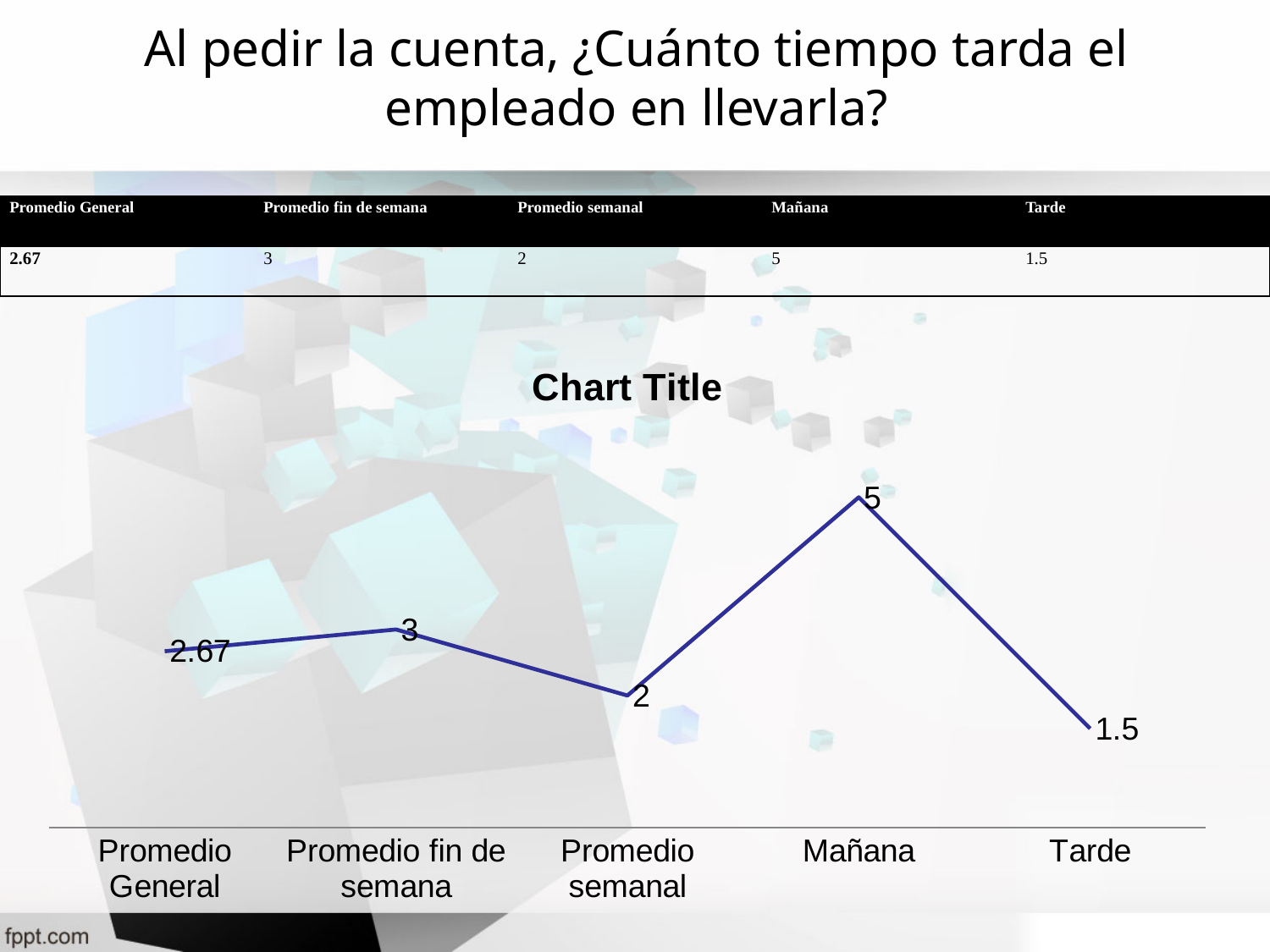
What is the difference between the values for Promedio fin de semana and Promedio semanal? 1 What is the value for Promedio General? 2.67 What is the difference between the values for Mañana and Tarde? 3.5 Which is larger, the value for Promedio General or the value for Promedio semanal? Promedio General Which category has the lowest value? Tarde How many categories are plotted on the x axis? 5 What kind of chart is shown? Line chart What is the title shown on the chart? Chart Title Which category has the highest value? Mañana What is the value for Mañana? 5 What is the value for Promedio fin de semana? 3 What is the value for Tarde? 1.5